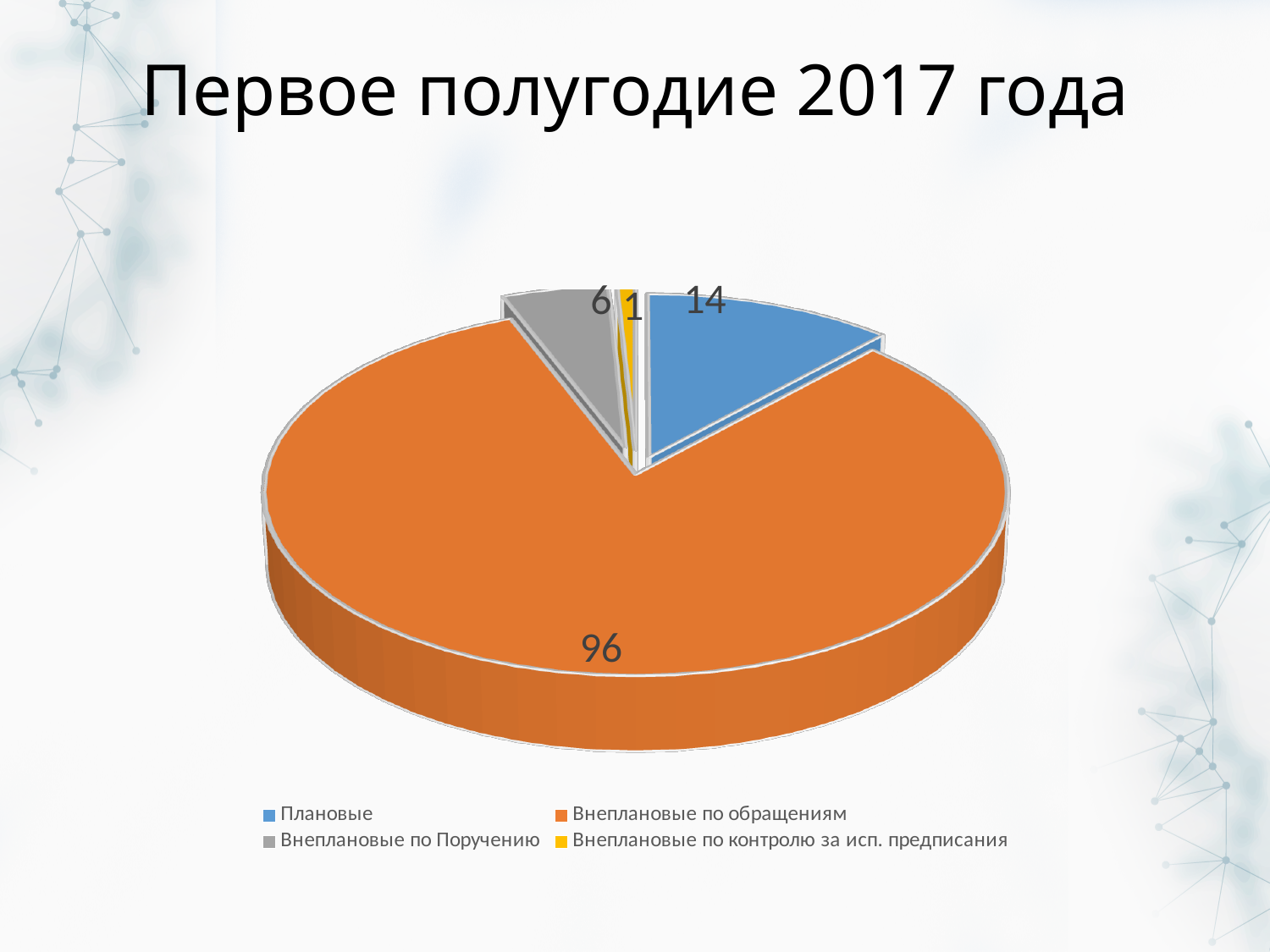
What is the difference between the values for Внеплановые по обращениям and Плановые? 82 What is the value for Плановые? 14 Which is larger, the value for Плановые or the value for Внеплановые по Поручению? Плановые What kind of chart is shown on the slide? pie chart What is the value for Внеплановые по Поручению? 6 Which category has the largest slice of the pie? Внеплановые по обращениям What is the value for Внеплановые по контролю за исп. предписания? 1 What is the total of all slices in the pie chart? 117 What is the title of the slide? Первое полугодие 2017 года Which category has the smallest slice of the pie? Внеплановые по контролю за исп. предписания How many categories does the pie chart have? 4 What is the value for Внеплановые по обращениям? 96